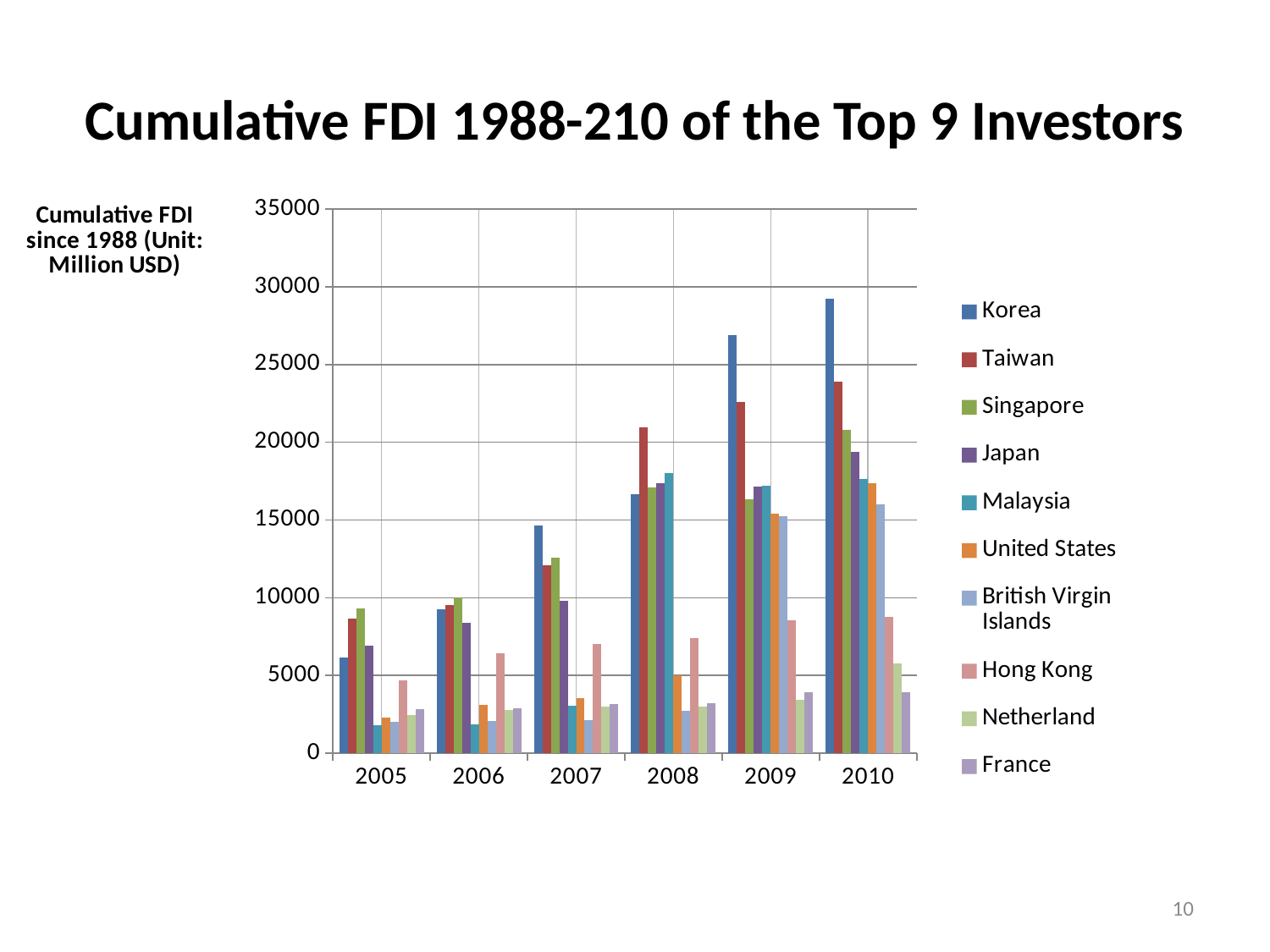
Is the value for Taiwan in 2008 greater or less than 20000? greater What kind of chart is shown on the slide? Bar chart Which investor has the highest cumulative FDI in 2010? Korea Which is larger in 2010, the value for Korea or the value for Taiwan? Korea Is the value for Korea in 2010 greater or less than 25000? greater How many years are shown along the x axis? 6 Does the cumulative FDI for Korea rise or fall from 2005 to 2010? Rises Which investor has the lowest cumulative FDI in 2010? France Which investor has the highest cumulative FDI in 2008? Taiwan Is the value for Hong Kong in 2010 greater or less than 10000? less How many series does the legend list? 10 What unit does the y-axis label say the values are in? Million USD